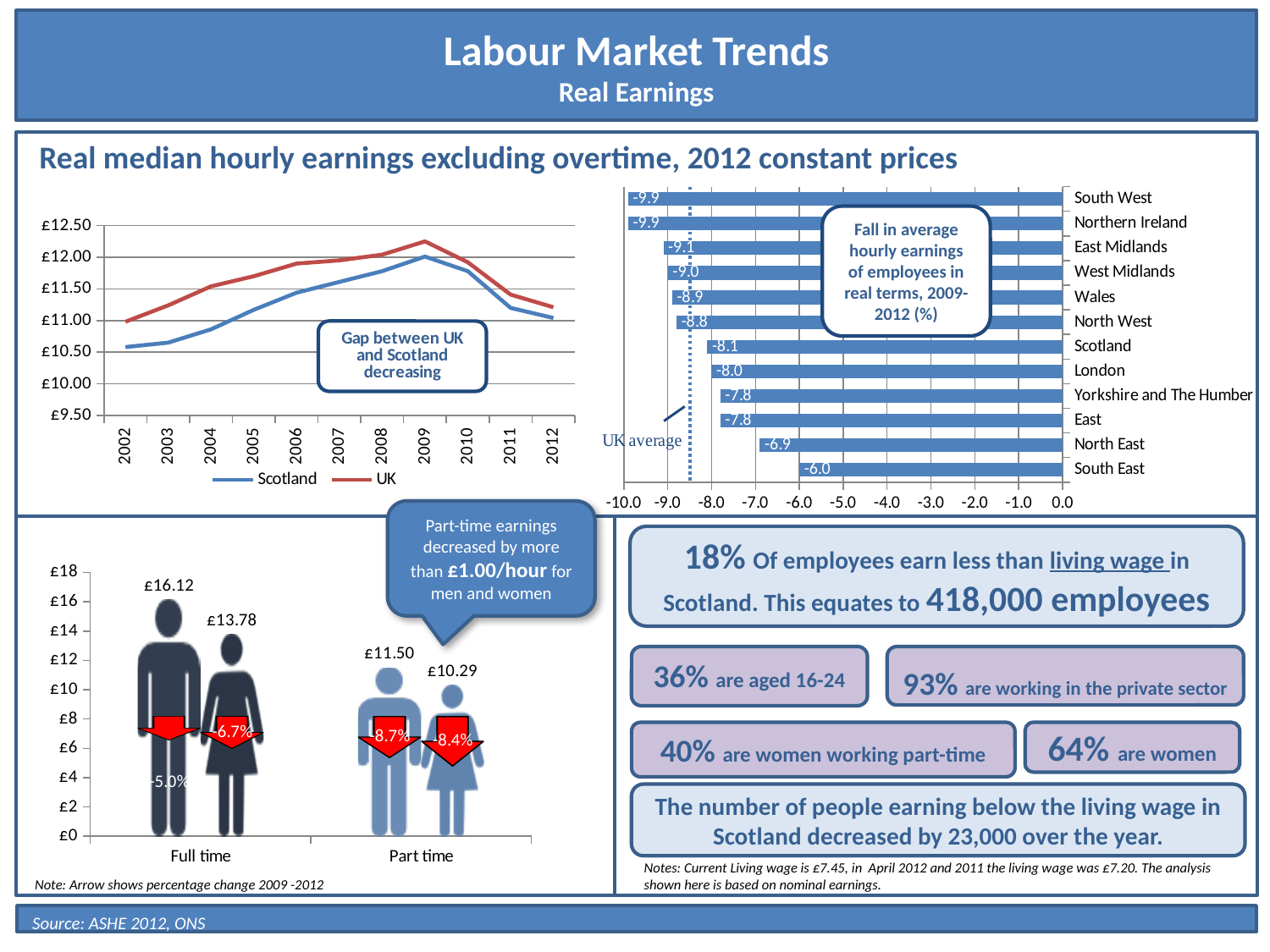
In the bottom-left bar chart of full time and part time earnings, what percentage change is shown on the arrow for full time women? -6.7% In the line chart of real median hourly earnings (top left), is the value for Scotland in 2002 greater or less than £11.00? less In the line chart of real median hourly earnings (top left), how many series does the legend list? 2 In the 'Fall in average hourly earnings of employees in real terms, 2009-2012 (%)' bar chart, which region has the smallest fall? South East In the bottom-left bar chart of full time and part time earnings, what is the full time hourly earnings value for men? £16.12 In the 'Fall in average hourly earnings of employees in real terms, 2009-2012 (%)' bar chart, what is the difference between the values for Scotland and South East? 2.1 In the line chart of real median hourly earnings (top left), which series is higher in 2009, Scotland or UK? UK In the 'Fall in average hourly earnings of employees in real terms, 2009-2012 (%)' bar chart, what is the value for Scotland? -8.1 In the bottom-left bar chart of full time and part time earnings, what is the difference between the part time values for men (£11.50) and women (£10.29)? £1.21 In the line chart of real median hourly earnings (top left), in which year does the UK series reach its highest value? 2009 In the 'Fall in average hourly earnings of employees in real terms, 2009-2012 (%)' bar chart, what is the value for North East? -6.9 In the 'Fall in average hourly earnings of employees in real terms, 2009-2012 (%)' bar chart, how many regions are shown? 12